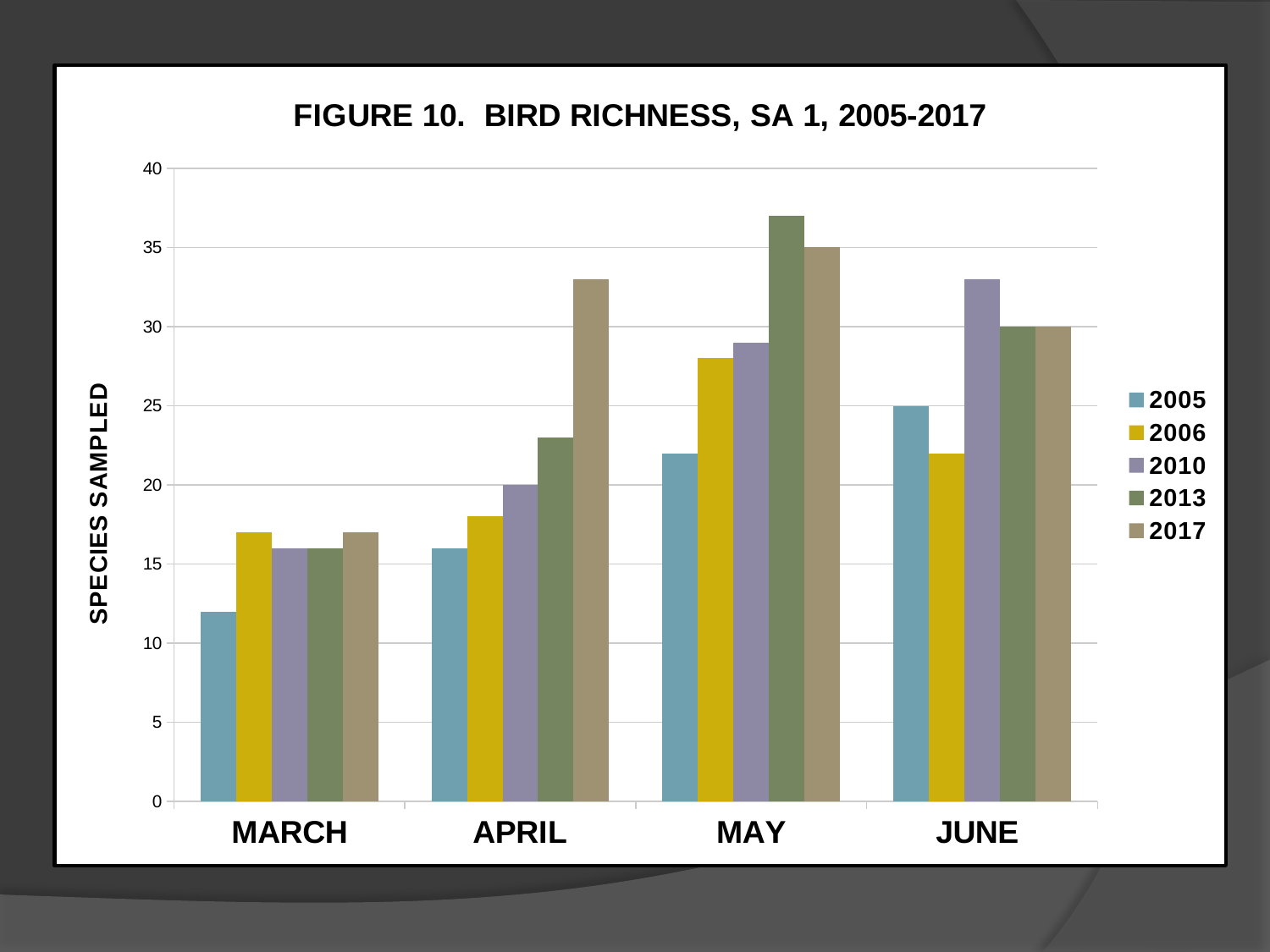
Which month and year has the highest bar in the chart? MAY, 2013 What is the title of the chart? FIGURE 10. BIRD RICHNESS, SA 1, 2005-2017 Which month and year has the lowest bar in the chart? MARCH, 2005 Is the value for 2005 in MARCH greater or less than 15? less How many series does the legend list? 5 What is the value for 2005 in JUNE? 25 How many months are shown on the x axis? 4 What is the value for 2017 in MAY? 35 What kind of chart is shown on the slide? Bar chart Is the value for 2017 in APRIL greater or less than 30? greater What is the value for 2010 in APRIL? 20 What is the label on the vertical axis? SPECIES SAMPLED